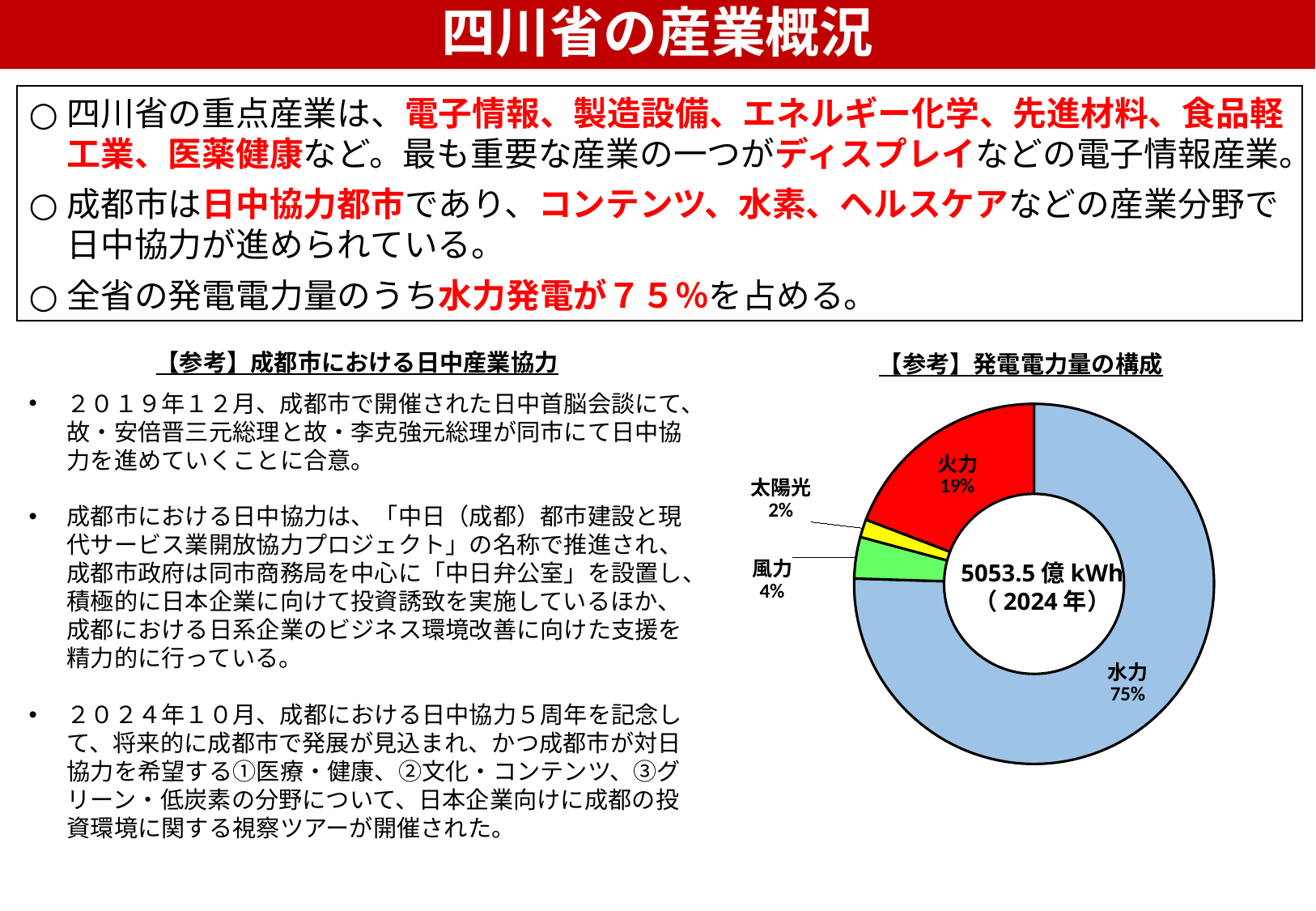
What is the title of the chart? 【参考】発電電力量の構成 What kind of chart is shown on the slide? Pie chart (doughnut) How many categories are shown in the pie chart? 4 Which category has the smallest share in the pie chart? 太陽光 Which category has the largest share in the pie chart? 水力 What share of the pie chart does 水力 (hydro) account for? 75% What share of the pie chart does 太陽光 (solar) account for? 2% What share of the pie chart does 火力 (thermal) account for? 19% Which has a larger share, 風力 or 太陽光? 風力 What total value and year are printed in the centre of the pie chart? 5053.5 億 kWh（2024 年） What is the difference in percentage points between the 水力 and 火力 shares? 56